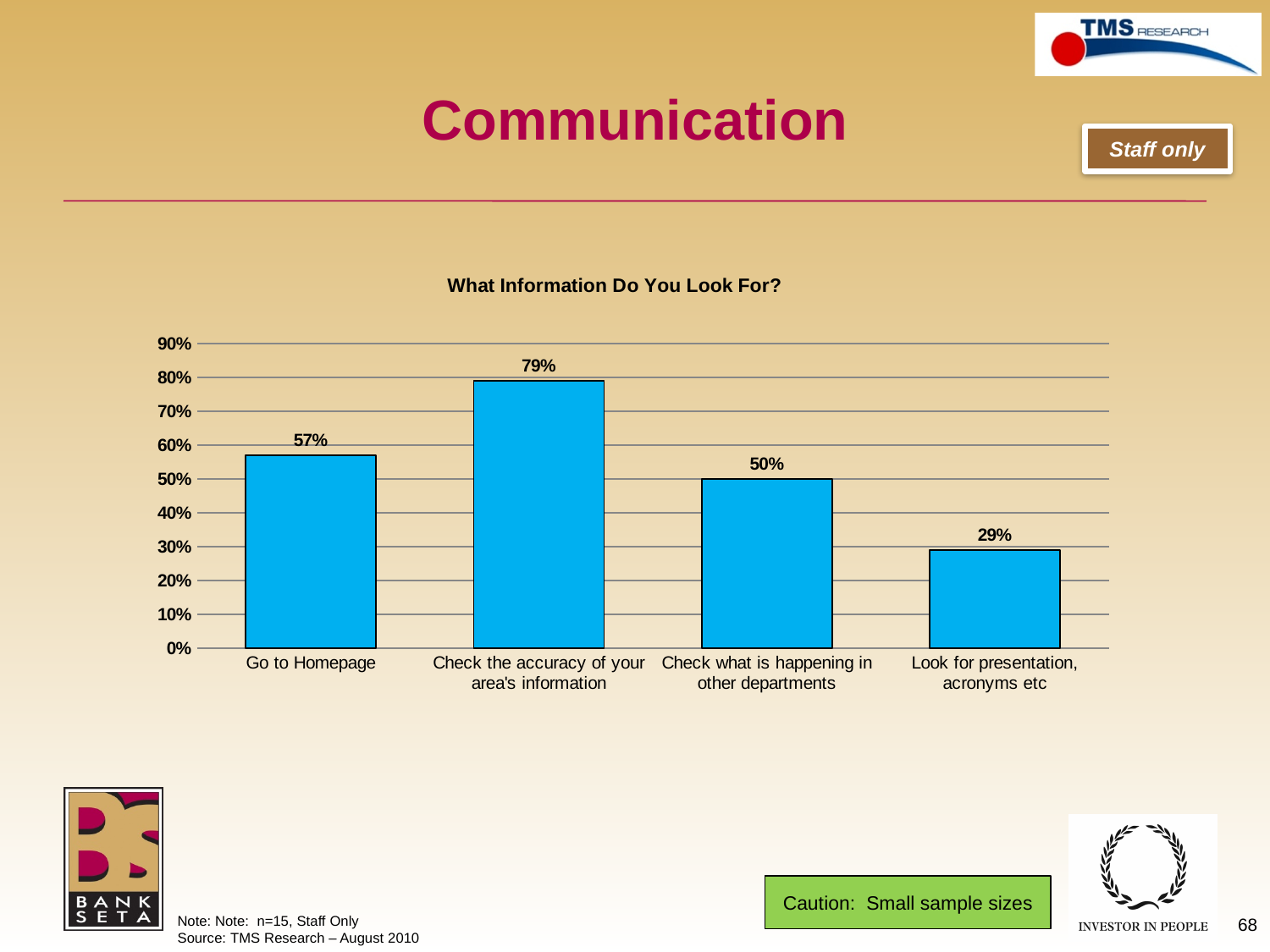
What percentage look for presentation, acronyms etc? 29% How many categories are shown in the chart? 4 Which is larger: 'Go to Homepage' or 'Check what is happening in other departments'? Go to Homepage What is the difference between 'Check the accuracy of your area's information' and 'Go to Homepage'? 22% Which category has the highest value? Check the accuracy of your area's information Which category has the lowest value? Look for presentation, acronyms etc What kind of chart is shown on the slide? Bar chart What is the difference between 'Check what is happening in other departments' and 'Look for presentation, acronyms etc'? 21% What is the value for 'Check the accuracy of your area's information'? 79% What is the title of the chart? What Information Do You Look For? What percentage of staff said they go to the homepage? 57% Is the value for 'Check what is happening in other departments' greater or less than 60%? less